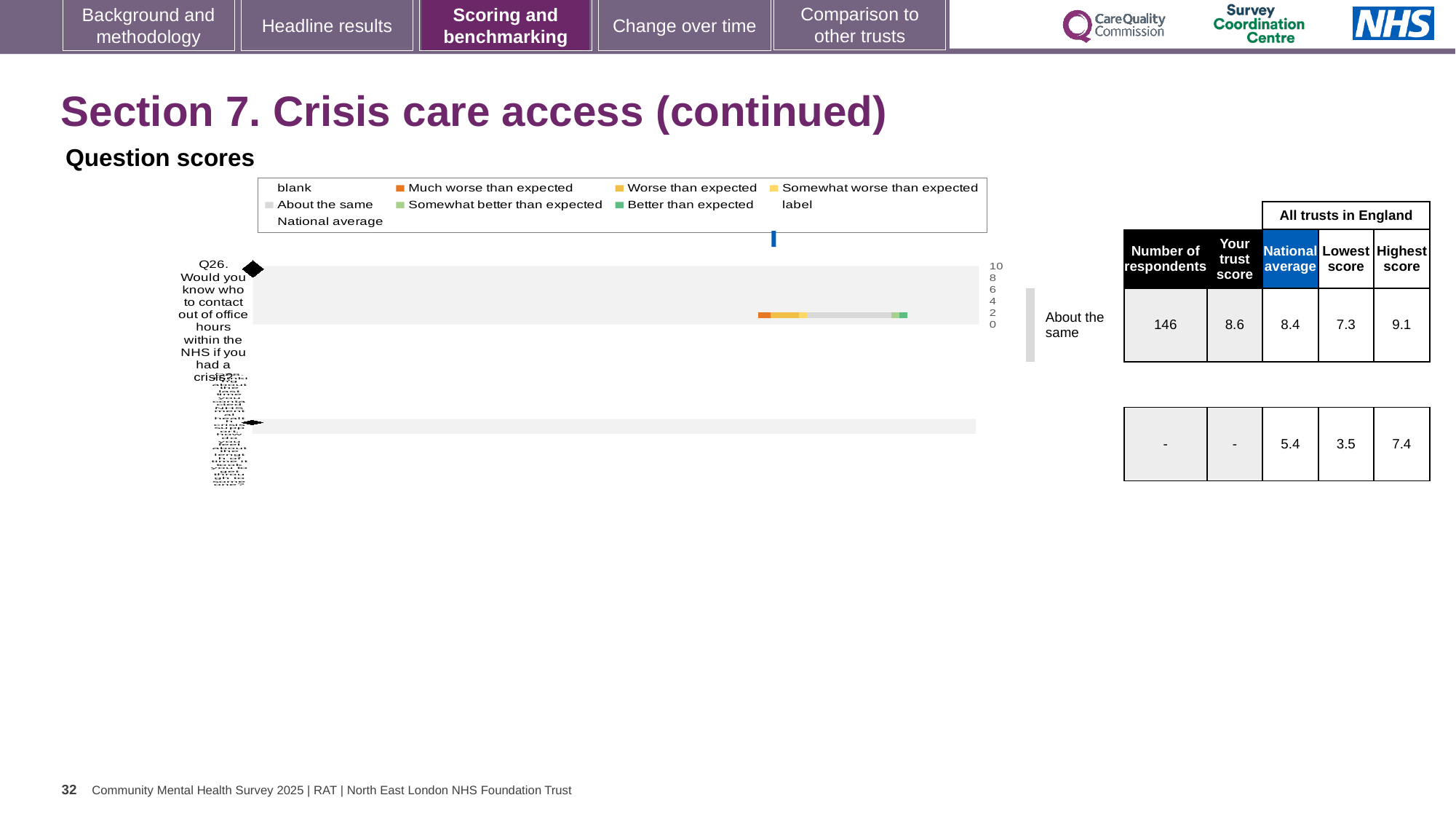
For Q26, is the trust score higher or lower than the national average? higher What is the trust score for Q26 (Would you know who to contact out of office hours within the NHS if you had a crisis?)? 8.6 What is the difference between the highest and lowest trust scores in England for Q26? 1.8 By how much does the trust score for Q26 exceed the national average? 0.2 What benchmark category is shown for Q26? About the same What is the highest score among all trusts in England for Q26? 9.1 In the second row of the table, what is the difference between the highest score and the lowest score? 3.9 What kind of chart is used to show the question scores? bar chart What is the national average score for Q26? 8.4 How many respondents answered Q26? 146 What is the lowest score among all trusts in England for Q26? 7.3 In the second row of the table, what is the national average score? 5.4